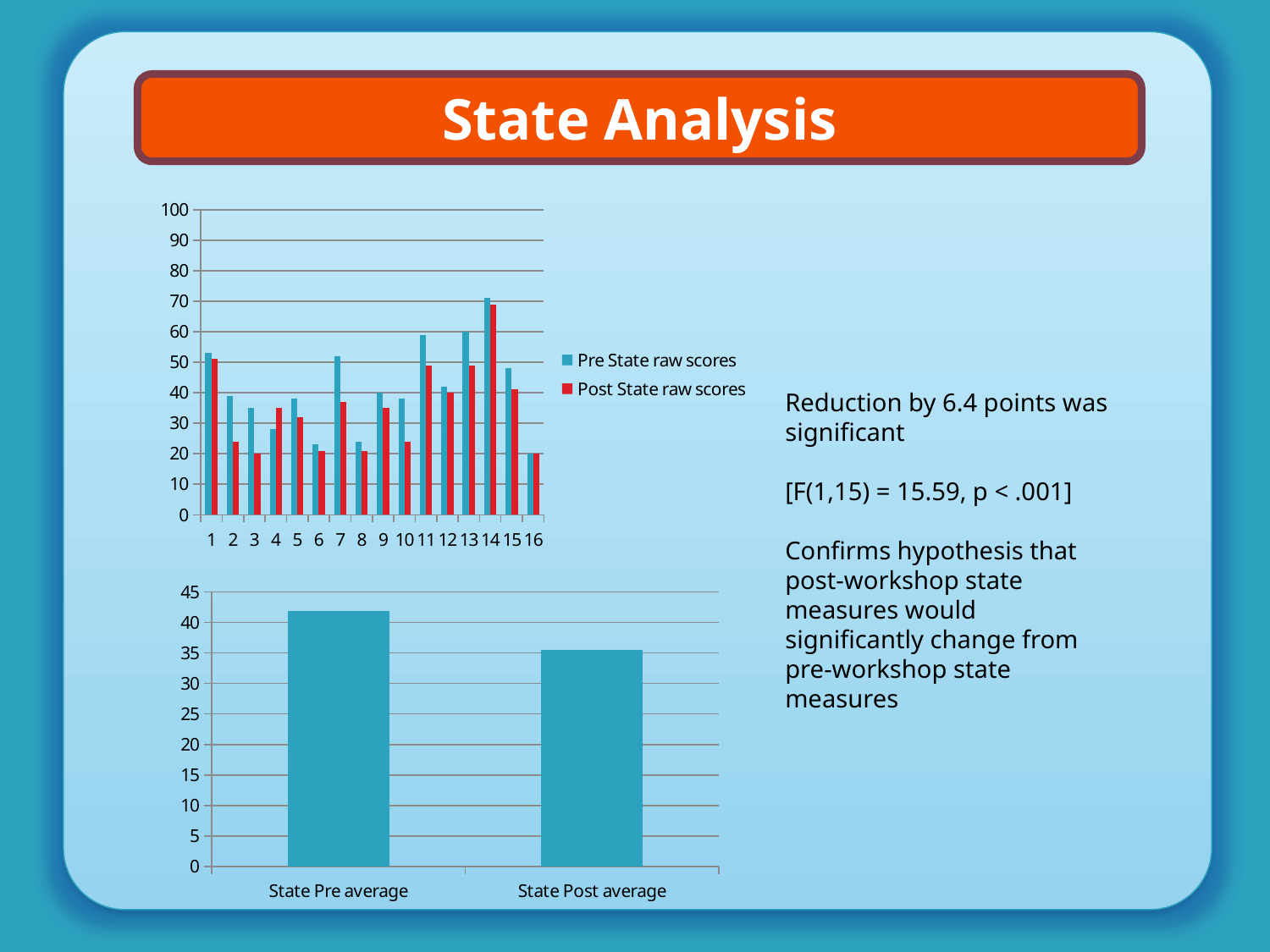
What kind of chart is the bottom chart? bar chart In the bottom chart, how many categories are shown? 2 In the bottom chart, is the value for State Post average greater or less than 40? less In the top chart, is the Pre State raw score for category 14 greater or less than 60? greater In the top chart, is the Post State raw score for category 3 greater or less than 30? less In the top chart, what are the two legend entries? Pre State raw scores, Post State raw scores In the top chart, how many categories are shown on the x axis? 16 In the top chart, for category 2, which is larger: the Pre State raw score or the Post State raw score? Pre State raw scores In the top chart, how many series does the legend list? 2 In the top chart, which category has the highest Pre State raw score? 14 In the bottom chart, which category has the higher value? State Pre average